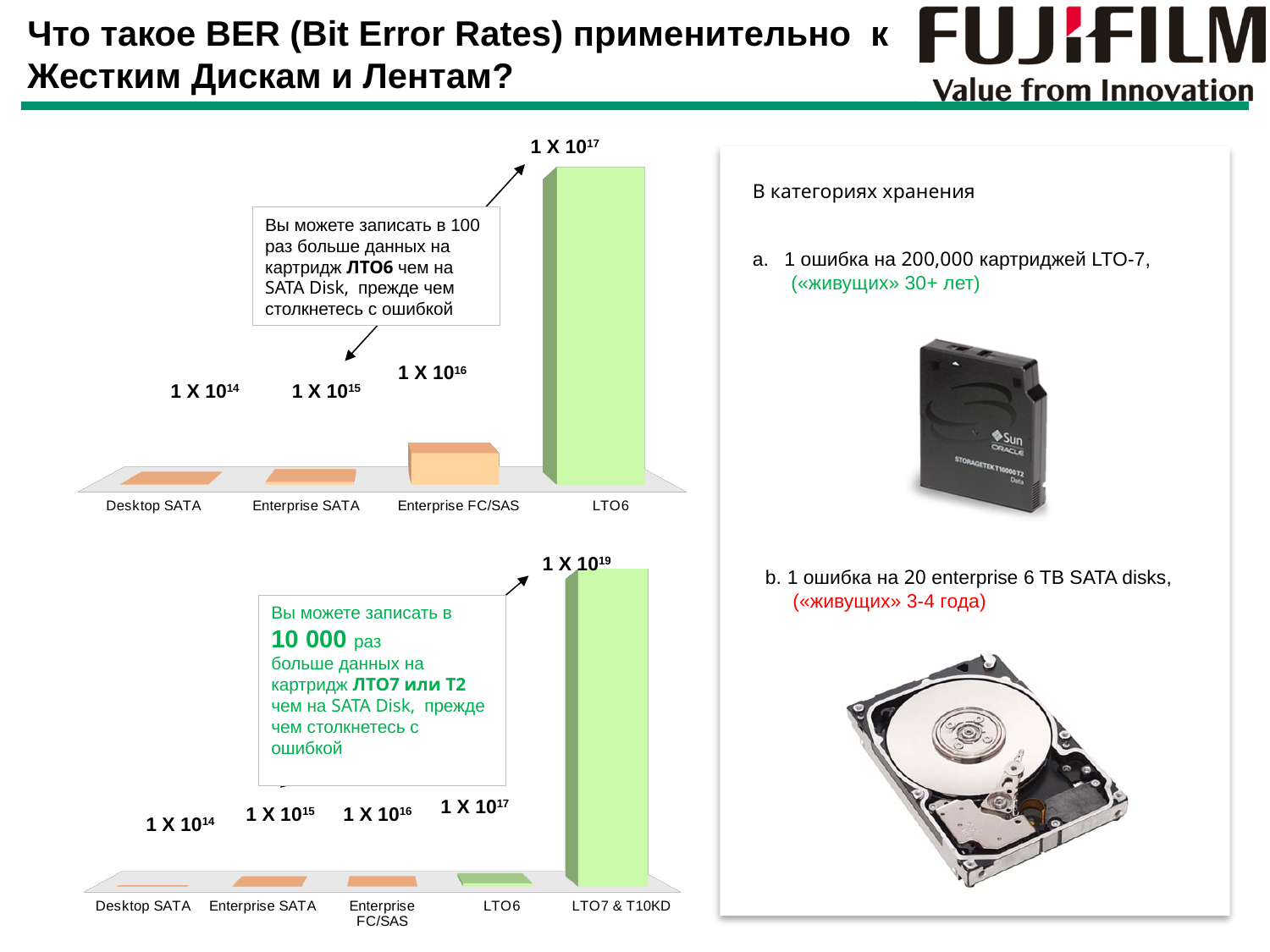
In the bottom chart, what is the value shown for LTO7 & T10KD? 1 X 10¹⁹ In the bottom chart, which category has the highest value? LTO7 & T10KD In the top chart, what is the value shown for LTO6? 1 X 10¹⁷ In the top chart, which category has the highest value? LTO6 How many categories are shown in the top chart? 4 How many categories are shown in the bottom chart? 5 In the top chart, what is the value shown for Enterprise FC/SAS? 1 X 10¹⁶ In the top chart, which category has the lowest value? Desktop SATA In the top chart, what is the value shown for Desktop SATA? 1 X 10¹⁴ In the bottom chart, which is larger: the value for LTO6 or the value for Enterprise FC/SAS? LTO6 In the bottom chart, what is the value shown for Enterprise SATA? 1 X 10¹⁵ What kind of chart is the top chart? Bar chart